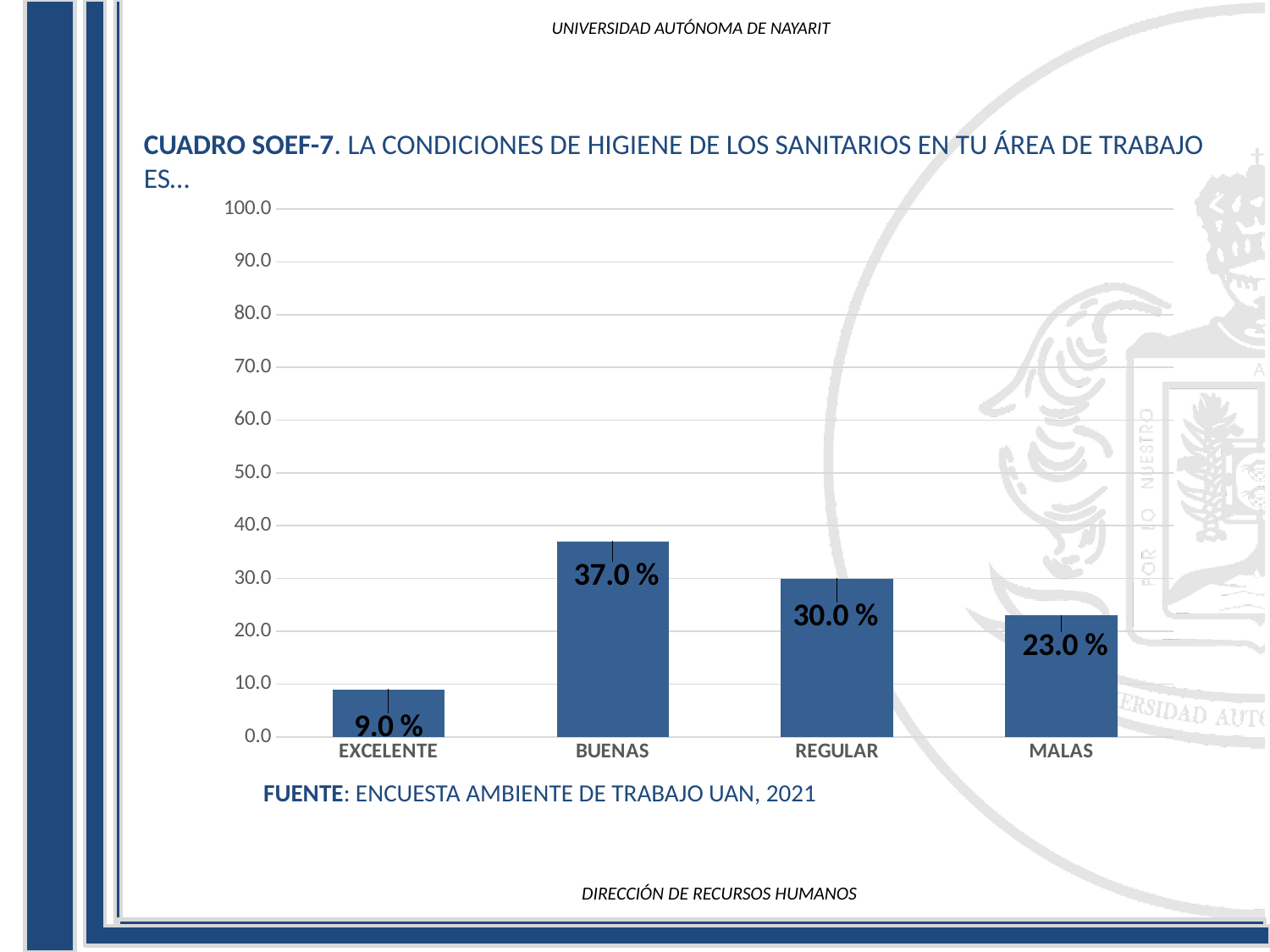
How many categories are shown on the x axis? 4 What source is cited below the chart? ENCUESTA AMBIENTE DE TRABAJO UAN, 2021 Is the value for MALAS greater or less than 20.0? greater What is the value for MALAS? 23.0 % What is the value for EXCELENTE? 9.0 % What kind of chart is shown on the slide? bar chart What is the difference between the values for BUENAS and REGULAR? 7.0 % What is the value for BUENAS? 37.0 % Which category has the lowest value? EXCELENTE Which category has the highest value? BUENAS Which is larger, the value for REGULAR or the value for MALAS? REGULAR What is the value for REGULAR? 30.0 %